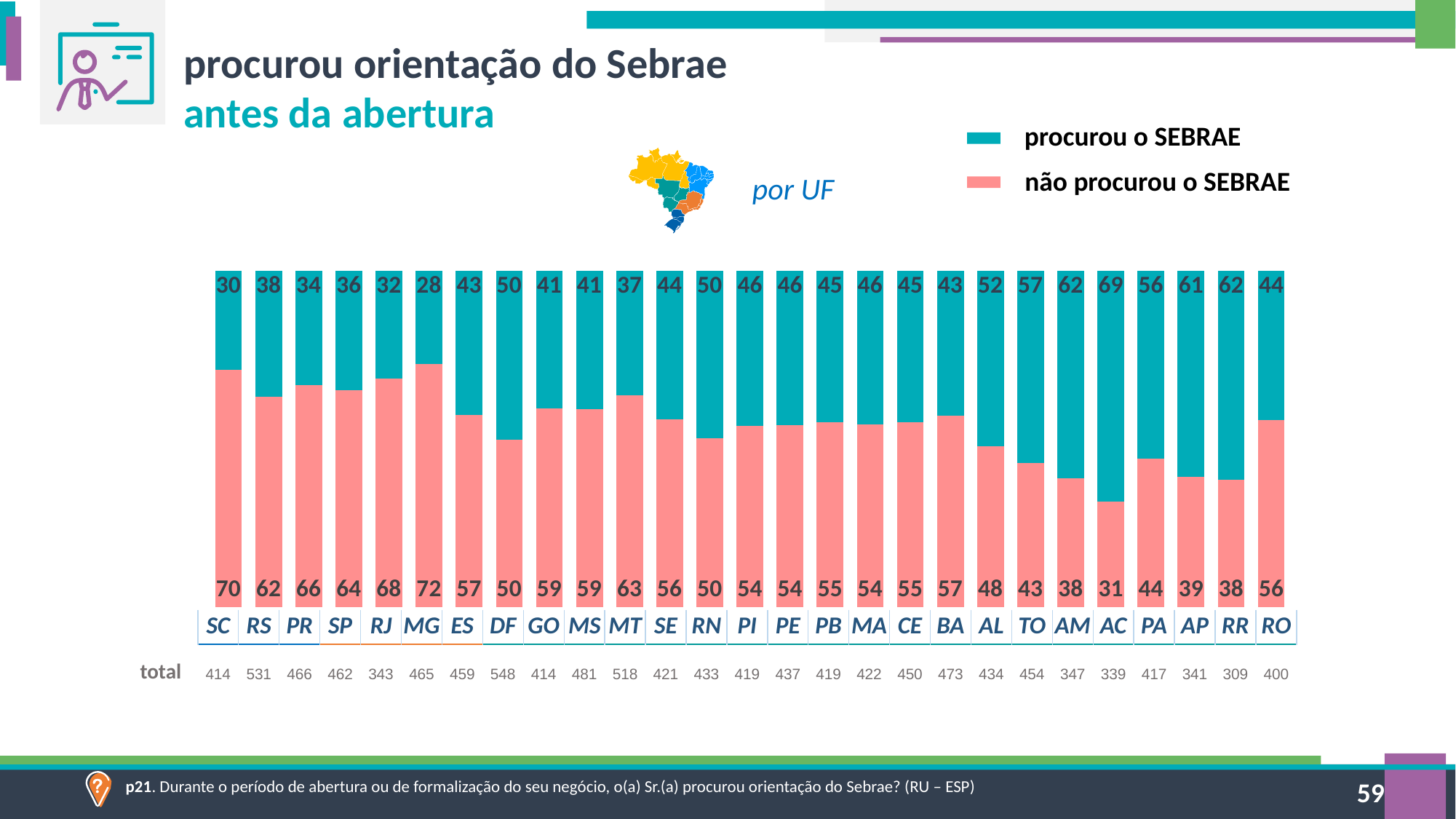
How many UFs (categories) are shown on the x axis? 27 What is the value of 'não procurou o SEBRAE' for MG? 72 Which is larger: the 'procurou o SEBRAE' value for AM or for TO? AM What kind of chart is shown on the slide? stacked bar chart What is the total of the stacked bar for DF? 100 What is the 'total' (sample size) shown below the chart for RR? 309 Which colour represents 'não procurou o SEBRAE' in the legend? pink Which UF has the lowest value for 'procurou o SEBRAE'? MG Which UF has the highest value for 'procurou o SEBRAE'? AC What is the difference between the 'procurou o SEBRAE' values for AC and SC? 39 What is the value of 'procurou o SEBRAE' for SC? 30 How many series does the legend list? 2